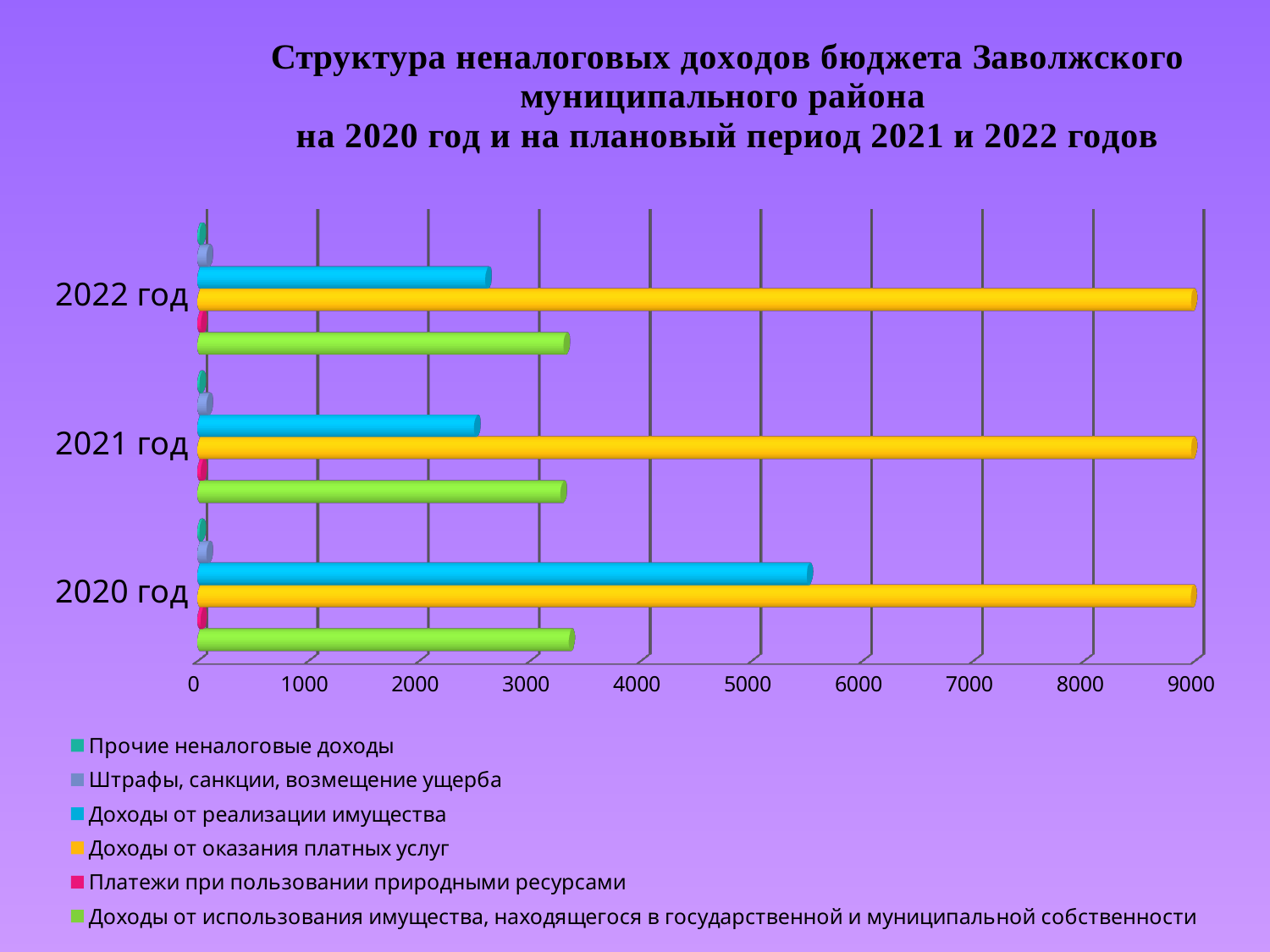
Which series has the highest value in 2020 год? Доходы от оказания платных услуг In 2021 год, which is larger: Доходы от реализации имущества or Доходы от использования имущества, находящегося в государственной и муниципальной собственности? Доходы от использования имущества, находящегося в государственной и муниципальной собственности Is the value for Доходы от реализации имущества in 2021 год greater or less than 3000? less Does the value for Доходы от реализации имущества rise or fall from 2020 год to 2021 год? fall Is the value for Доходы от реализации имущества in 2020 год greater or less than 5000? greater How many series does the legend list? 6 What colour represents Доходы от оказания платных услуг in the legend? yellow Which year has the larger value for Доходы от реализации имущества, 2020 год or 2022 год? 2020 год Is the value for Доходы от оказания платных услуг in 2022 год greater or less than 8000? greater What kind of chart is shown on the slide? bar chart How many year categories are shown on the chart? 3